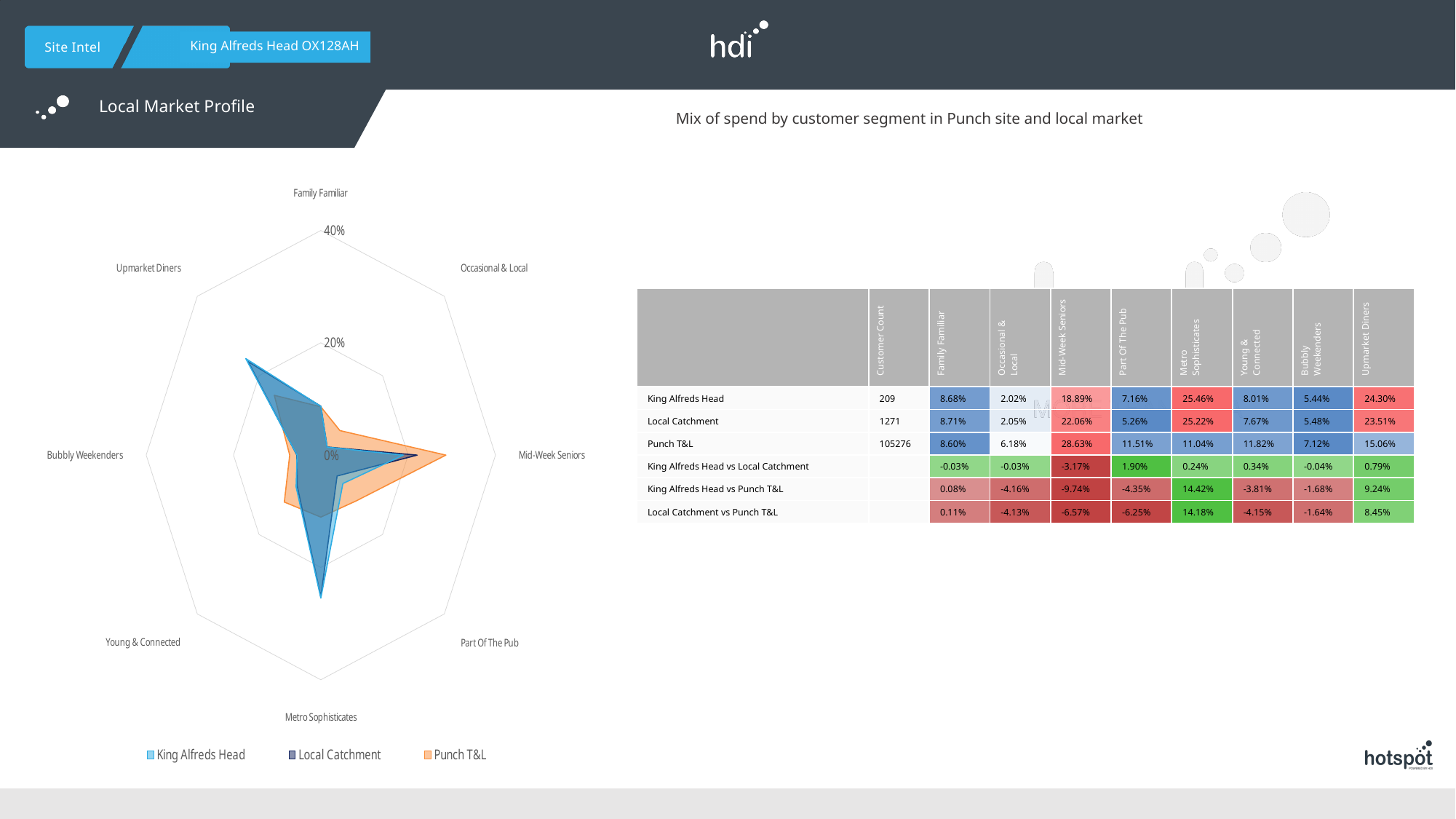
What is the Mid-Week Seniors share of spend for King Alfreds Head? 18.89% Which customer segment has the lowest share of spend for King Alfreds Head? Occasional & Local On the radar chart, is the Punch T&L value for Mid-Week Seniors greater or less than 20%? greater What is the highest percentage tick shown on the radar chart's axis? 40% On the radar chart, is the King Alfreds Head value for Metro Sophisticates greater or less than 20%? greater On the radar chart, is the Punch T&L value for Metro Sophisticates greater or less than 20%? less For Mid-Week Seniors, which is larger: the Punch T&L value or the King Alfreds Head value? Punch T&L What kind of chart is shown on the left of the slide? radar chart Which customer segment has the highest share of spend for Punch T&L? Mid-Week Seniors How many series does the radar chart's legend list? 3 How many customer segments (axes) does the radar chart have? 8 What are the three series named in the radar chart legend? King Alfreds Head, Local Catchment, Punch T&L